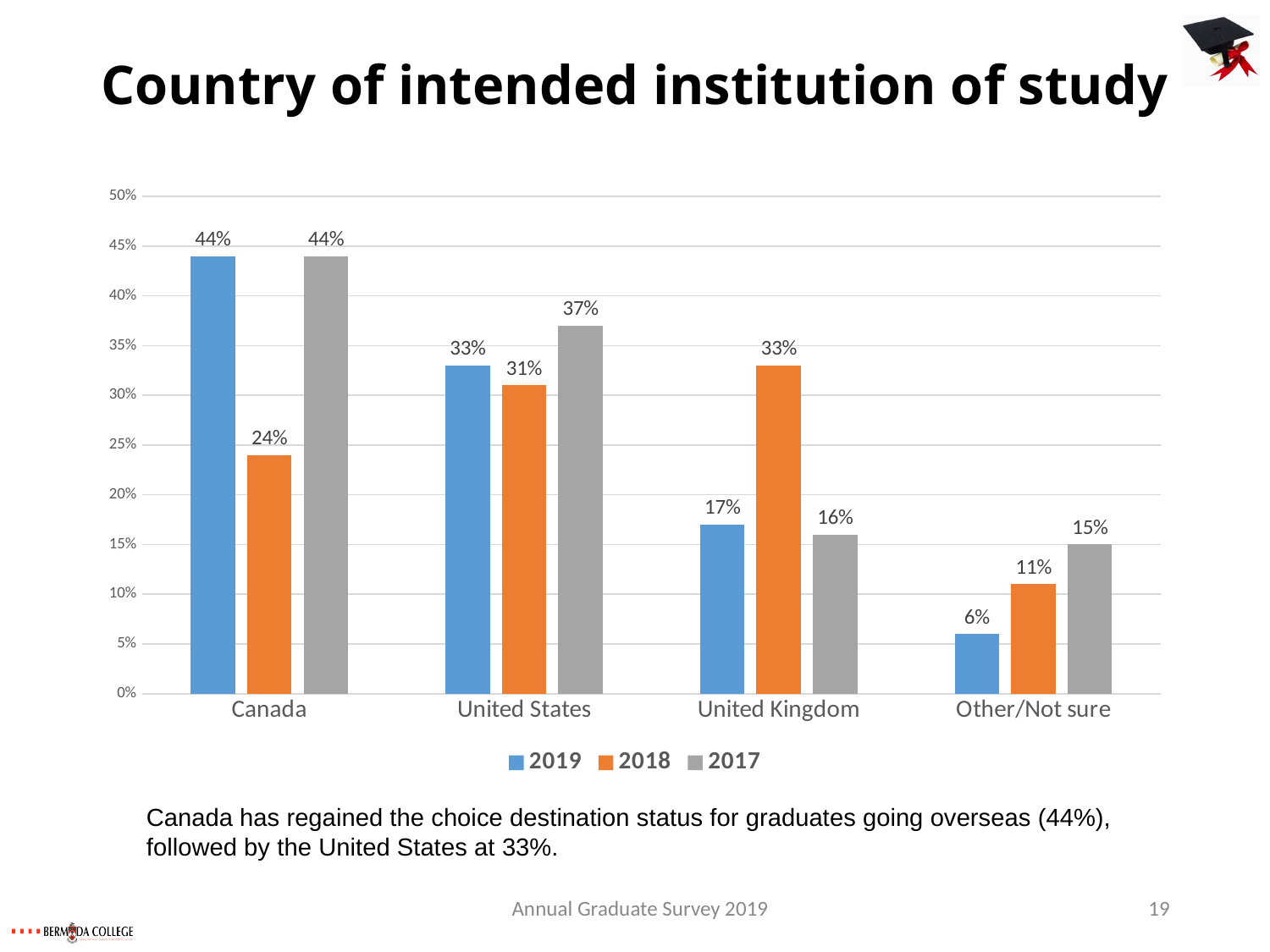
What is the 2017 value for Other/Not sure? 15% How many series does the legend list? 3 How many categories are shown on the x axis? 4 What kind of chart is shown on the slide? Bar chart Which is larger for the United States: the 2019 value or the 2017 value? 2017 What is the difference between the 2017 and 2018 values for Canada? 20% Do the 2017 values rise or fall from Canada to Other/Not sure along the x axis? Fall Which category has the lowest 2019 value? Other/Not sure What is the title of the chart? Country of intended institution of study What is the 2019 value for Canada? 44% Which category has the highest 2018 value? United Kingdom What is the 2018 value for the United Kingdom? 33%